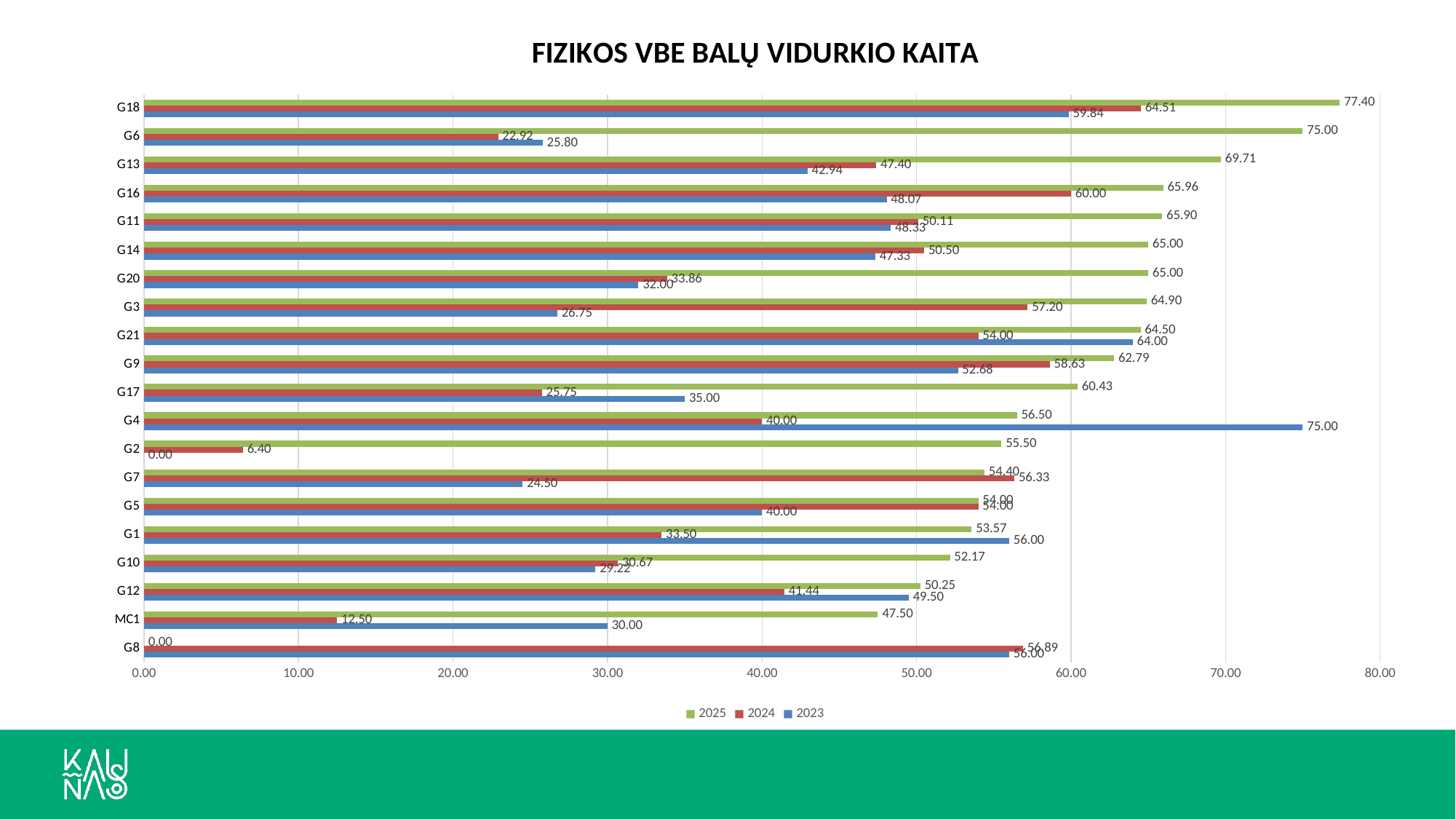
What is the title of the chart? FIZIKOS VBE BALŲ VIDURKIO KAITA Which category has the highest 2025 value? G18 How many categories are shown on the chart? 20 What is the difference between the 2023 and 2025 values for G4? 18.50 Which is larger for G7, the 2024 value or the 2025 value? 2024 What is the 2025 value for G18? 77.40 What is the difference between the 2025 and 2024 values for G18? 12.89 Which category has the lowest 2025 value? G8 What kind of chart is shown on the slide? Bar chart How many series does the legend list? 3 What is the 2024 value for MC1? 12.50 What is the 2023 value for G4? 75.00